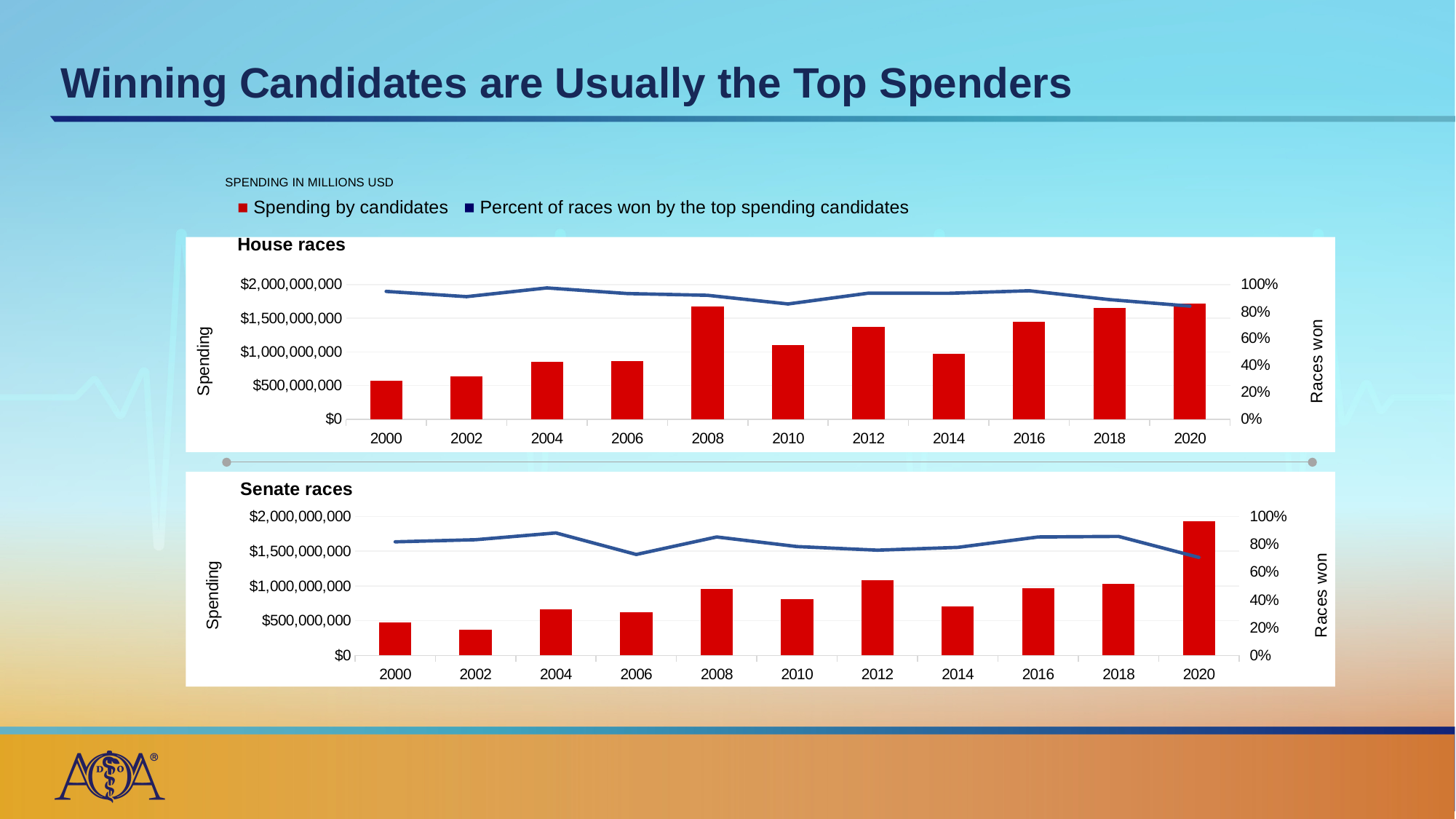
In the House races chart, is spending by candidates in 2008 greater or less than $1,500,000,000? greater In the House races chart, which year has the lowest spending by candidates? 2000 How many years are shown on the x axis of the Senate races chart? 11 In the Senate races chart, is the percent of races won by the top spending candidates in 2020 greater or less than 80%? less In the Senate races chart, which year has higher spending by candidates, 2000 or 2020? 2020 In the House races chart, which year has higher spending by candidates, 2008 or 2014? 2008 In the Senate races chart, is spending by candidates in 2006 greater or less than $1,000,000,000? less In the Senate races chart, which year has the lowest spending by candidates? 2002 How many series does the legend list? 2 What kind of chart is the House races chart? bar chart with a line In the Senate races chart, which year has the highest spending by candidates? 2020 What colour are the spending by candidates bars? red